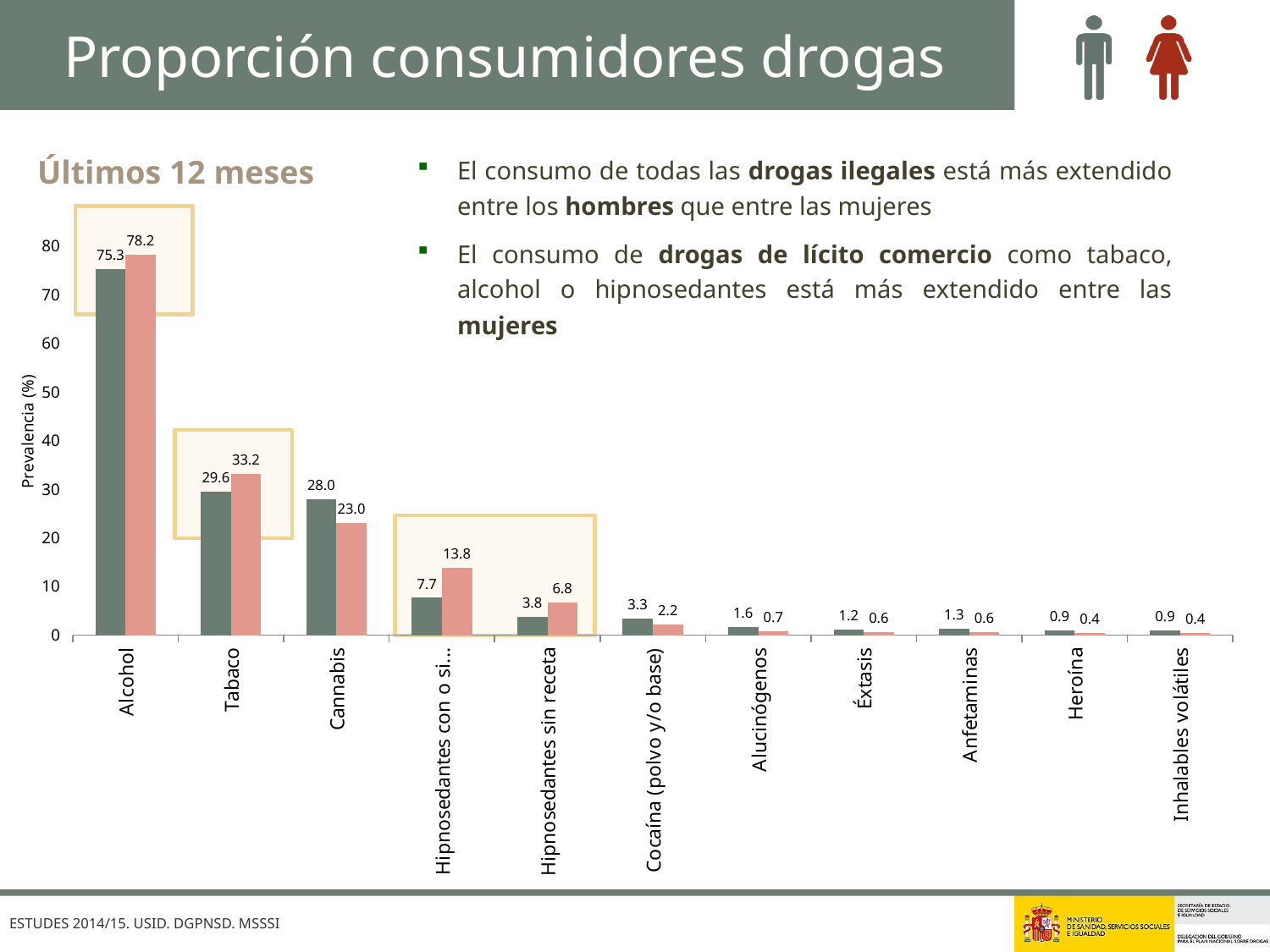
What is the difference between the pink bar and the grey bar for Hipnosedantes sin receta? 3.0 How many drug categories are shown on the x axis of the chart? 11 What is the value of the pink bar for Tabaco? 33.2 What is the value of the grey bar for Cocaína (polvo y/o base)? 3.3 What is the label of the y axis of the chart? Prevalencia (%) What is the value of the pink bar for Cannabis? 23.0 For Tabaco, which is larger, the grey bar or the pink bar? the pink bar Is the grey bar for Alcohol greater or less than 70? greater What is the difference between the grey bar and the pink bar for Cannabis? 5.0 What is the value of the grey bar for Alcohol? 75.3 What type of chart is shown on the slide? bar chart Which category has the highest pink bar? Alcohol